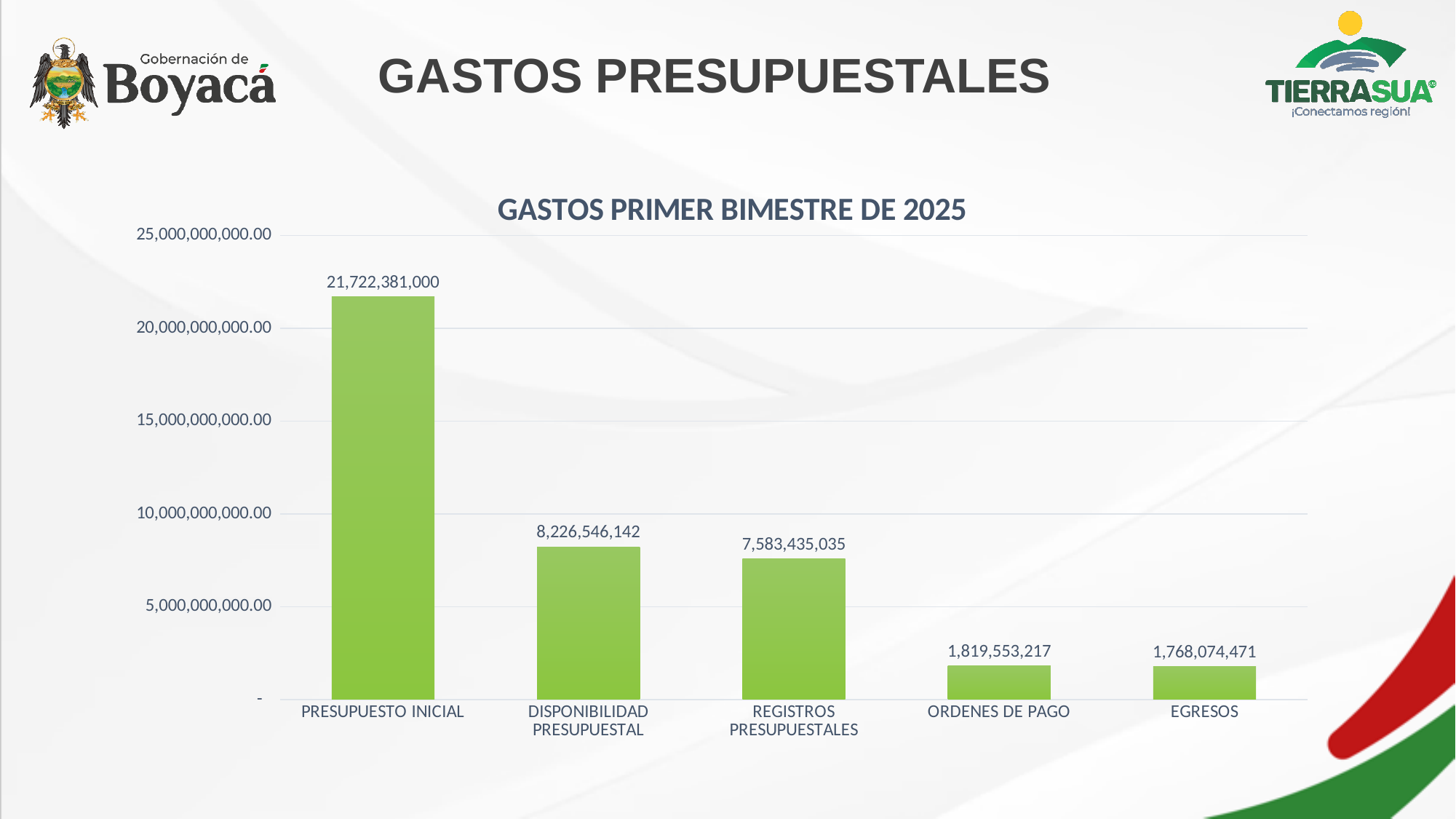
Do the values rise or fall from left to right along the x axis? Fall What is the value for PRESUPUESTO INICIAL? 21,722,381,000 What is the value for DISPONIBILIDAD PRESUPUESTAL? 8,226,546,142 How many categories are shown in the chart? 5 What is the value for ORDENES DE PAGO? 1,819,553,217 Which category has the lowest value? EGRESOS What is the difference between DISPONIBILIDAD PRESUPUESTAL and REGISTROS PRESUPUESTALES? 643,111,107 What is the value for REGISTROS PRESUPUESTALES? 7,583,435,035 Which category has the highest value? PRESUPUESTO INICIAL What type of chart is shown on the slide? Bar chart What is the title of the chart? GASTOS PRIMER BIMESTRE DE 2025 What is the value for EGRESOS? 1,768,074,471